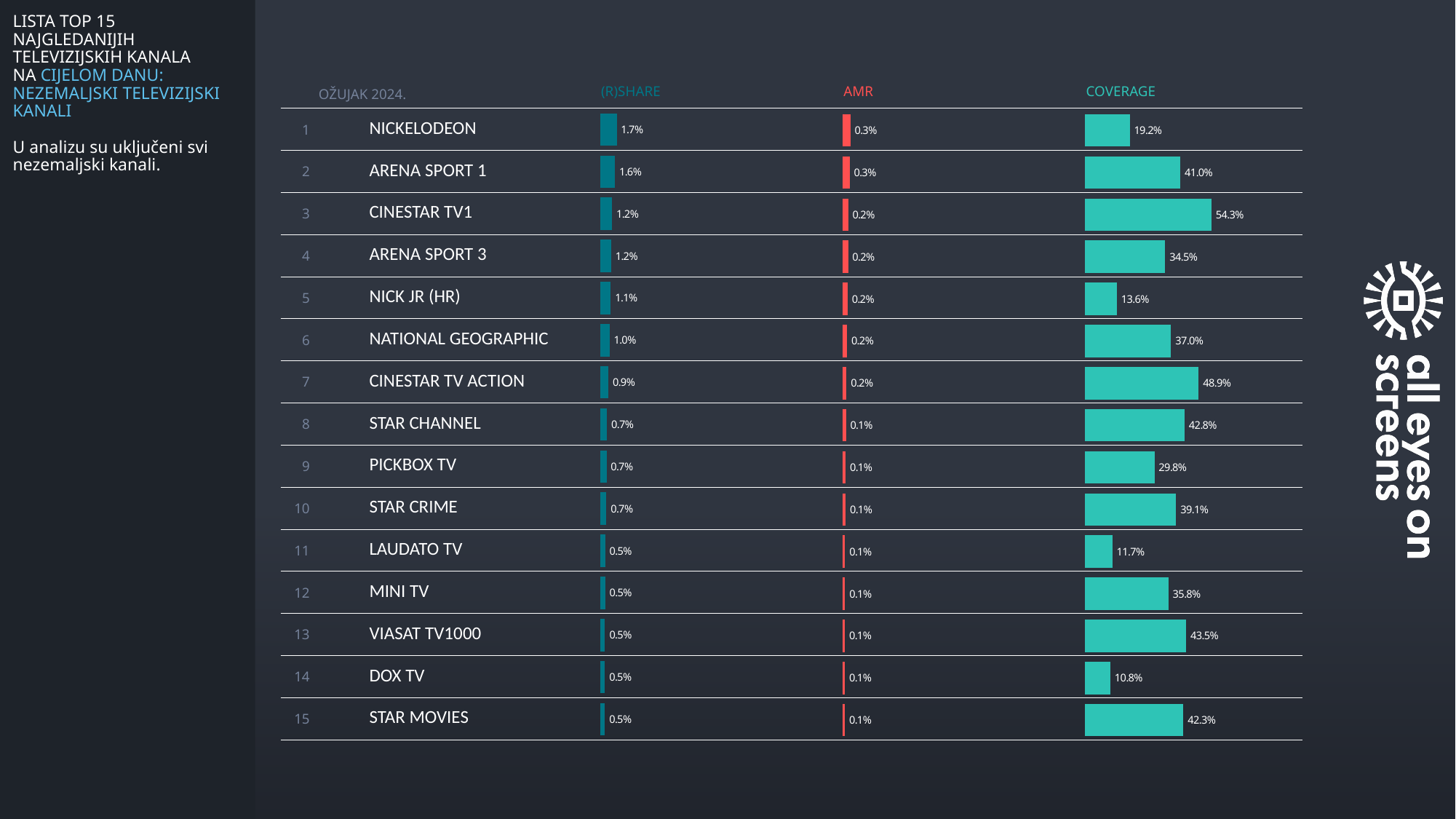
Which channel has the highest COVERAGE value? CINESTAR TV1 What is the AMR value for ARENA SPORT 1? 0.3% What month and year does the chart header indicate? OŽUJAK 2024. What is the COVERAGE value for CINESTAR TV ACTION? 48.9% Which channel has the highest (R)SHARE value? NICKELODEON What is the (R)SHARE value for NICKELODEON? 1.7% Which channel has the lowest COVERAGE value? DOX TV What is the difference in COVERAGE between CINESTAR TV1 and NICK JR (HR)? 40.7% How many channels are listed in the chart? 15 Which has a larger COVERAGE value, STAR CHANNEL or PICKBOX TV? STAR CHANNEL What kind of chart is used to show the (R)SHARE, AMR and COVERAGE values? Bar chart What is the COVERAGE value for LAUDATO TV? 11.7%